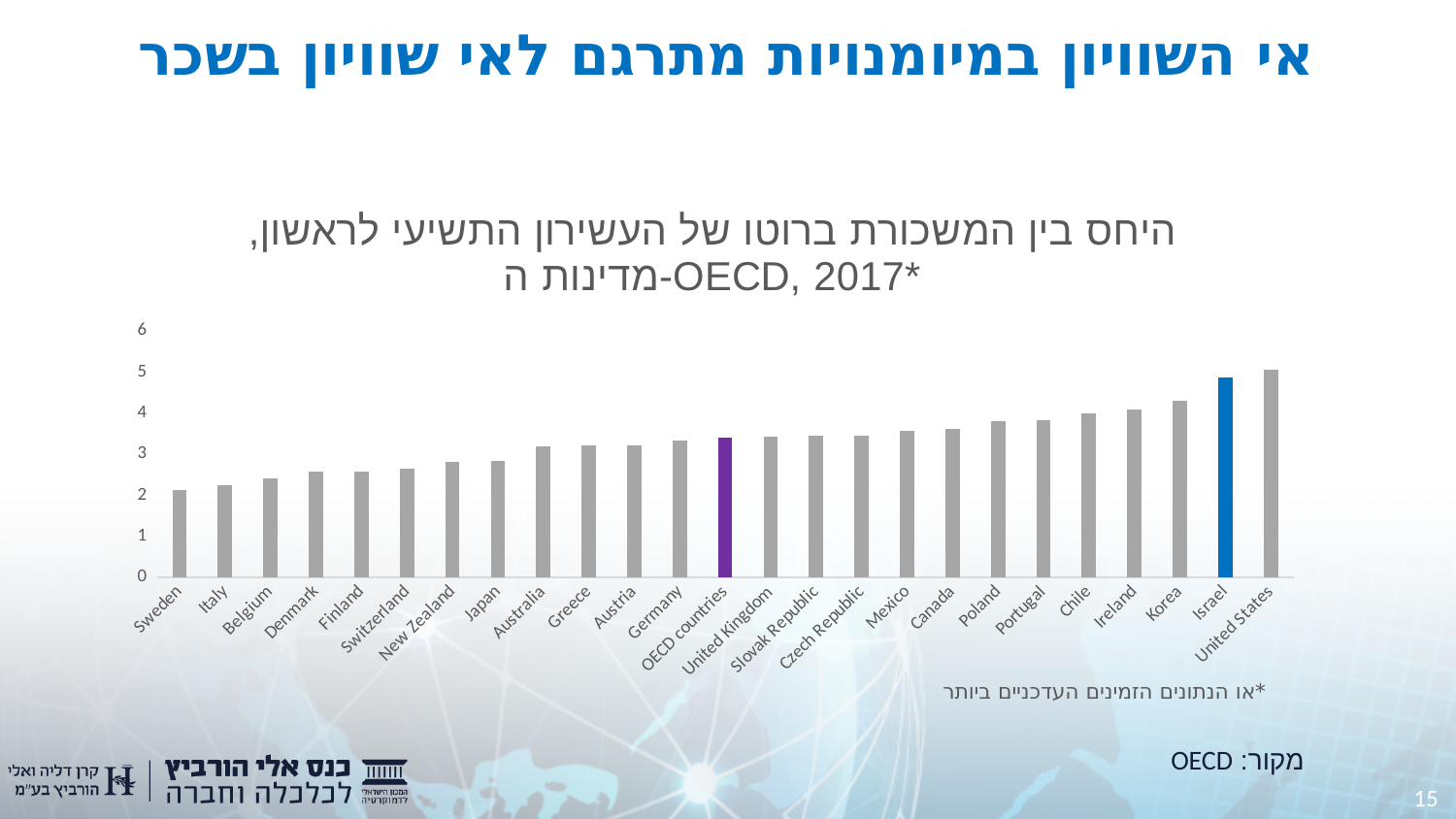
Is the value for Japan greater or less than 3? less Is the value for Israel greater or less than 4? greater Is the value for Sweden greater or less than 3? less Which category has the highest bar on the chart? United States Do the bar values generally rise or fall from left to right along the x axis? rise Which category has the lowest bar on the chart? Sweden How many countries/categories are plotted on the chart? 25 What colour is the bar for Israel? blue What kind of chart is shown on the slide? bar chart Which is larger, the value for Israel or the value for Sweden? Israel